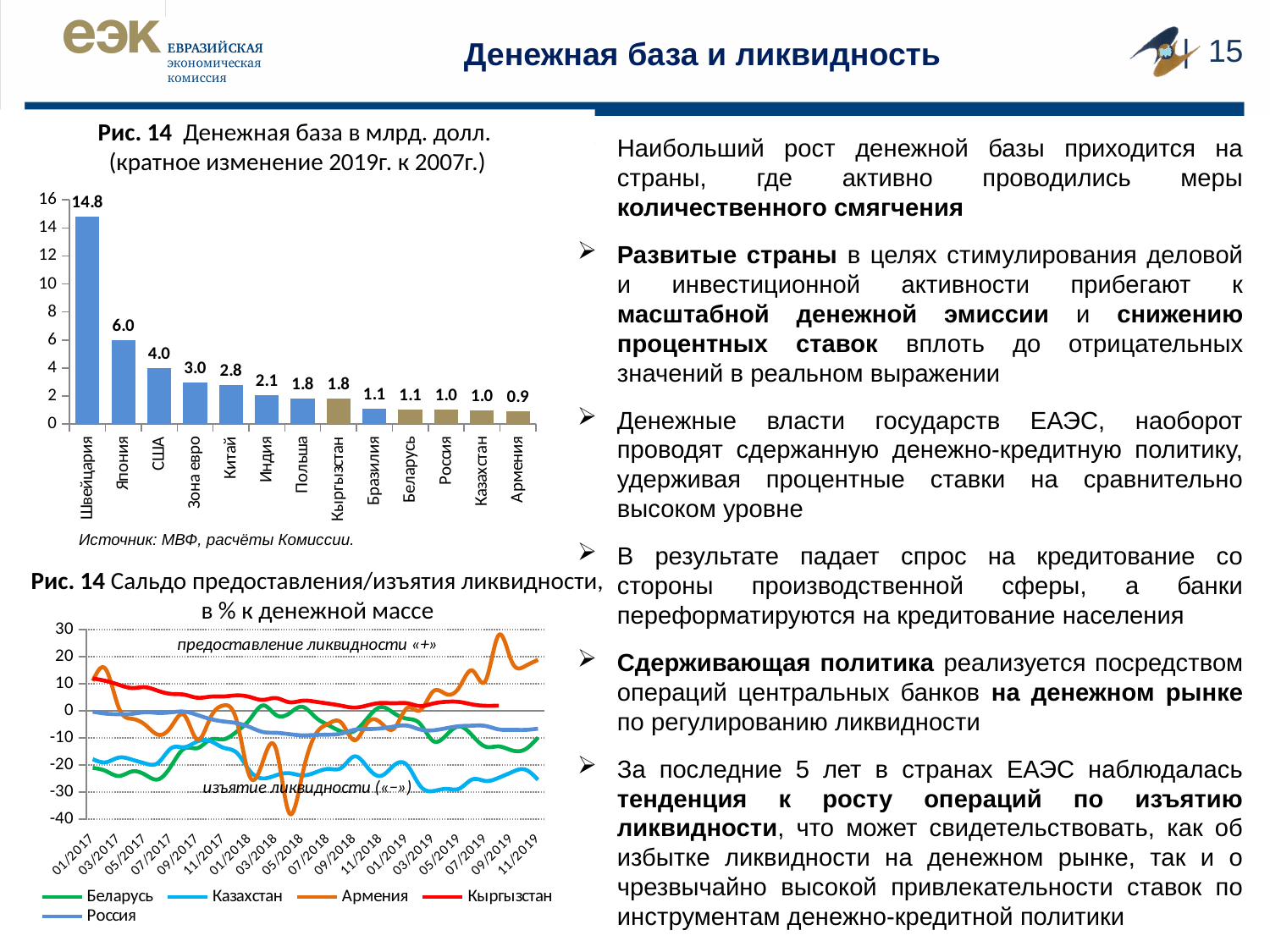
On the top chart (Денежная база в млрд. долл.), which country has the lowest value? Армения How many series does the legend of the bottom chart (Сальдо предоставления/изъятия ликвидности) list? 5 How many countries are shown on the top bar chart (Денежная база в млрд. долл.)? 13 On the top chart (Денежная база в млрд. долл.), what is the value for Швейцария? 14.8 On the top chart (Денежная база в млрд. долл.), what is the value for Япония? 6.0 On the top chart (Денежная база в млрд. долл.), what is the difference between the values for США and Зона евро? 1.0 On the top chart (Денежная база в млрд. долл.), which country has the highest value? Швейцария What kind of chart is the top chart (Денежная база в млрд. долл.)? Bar chart What kind of chart is the bottom chart (Сальдо предоставления/изъятия ликвидности)? Line chart On the top chart (Денежная база в млрд. долл.), what is the value for Кыргызстан? 1.8 On the top chart (Денежная база в млрд. долл.), which is larger, the value for Китай or the value for Индия? Китай